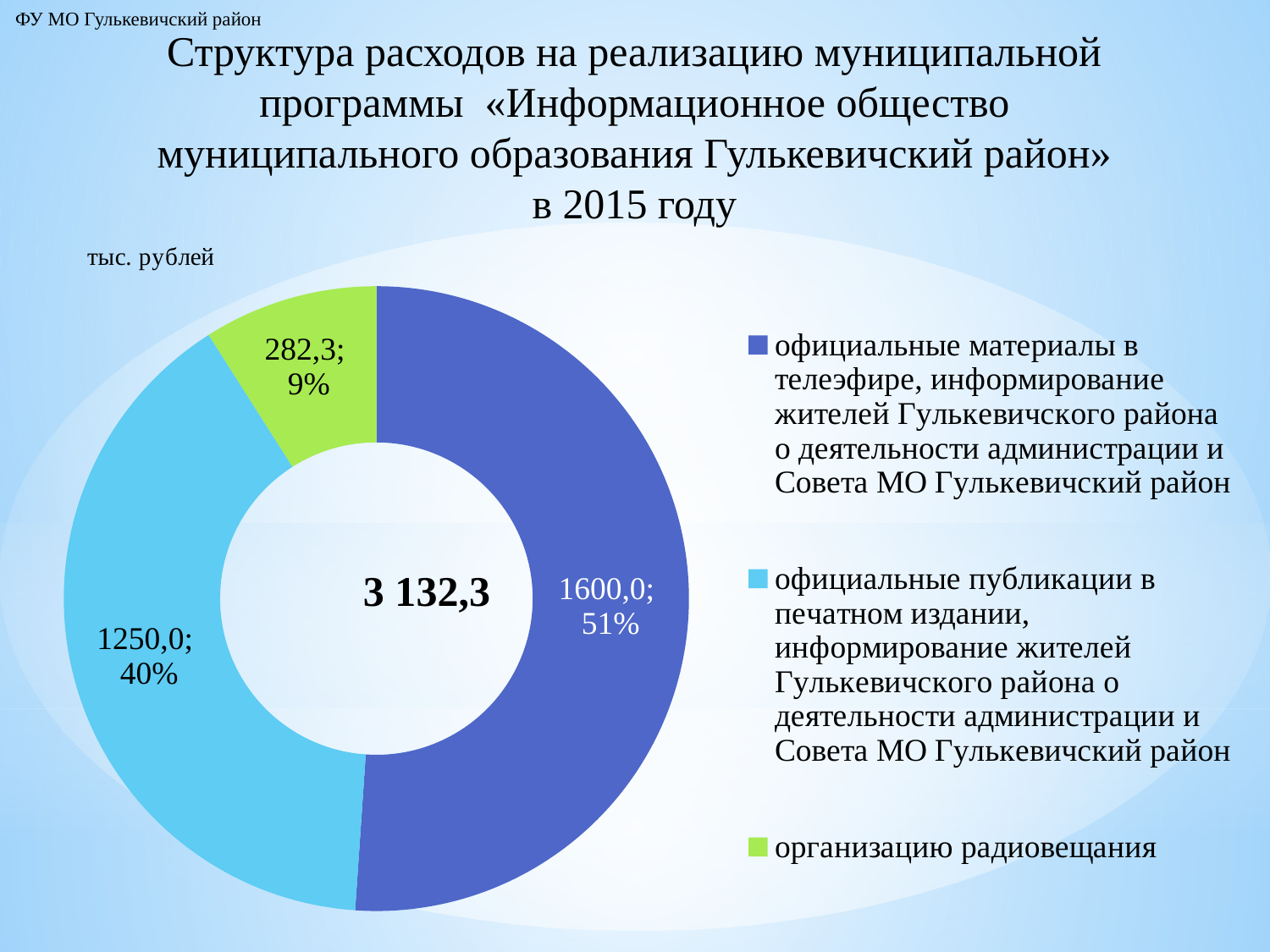
How many slices does the chart have? 3 Which category has the smallest share of expenses? организацию радиовещания What share of the total does организацию радиовещания account for? 9% What is the value (тыс. рублей) for официальные публикации в печатном издании? 1250,0 What is the value (тыс. рублей) for официальные материалы в телеэфире? 1600,0 What total value is shown in the centre of the chart? 3 132,3 Which category has the largest share of expenses? официальные материалы в телеэфире What share of the total do официальные публикации в печатном издании account for? 40% What is the value (тыс. рублей) for организацию радиовещания? 282,3 What kind of chart is shown on the slide? doughnut chart What is the difference between the values for официальные материалы в телеэфире and официальные публикации в печатном издании? 350,0 How many entries does the legend list? 3